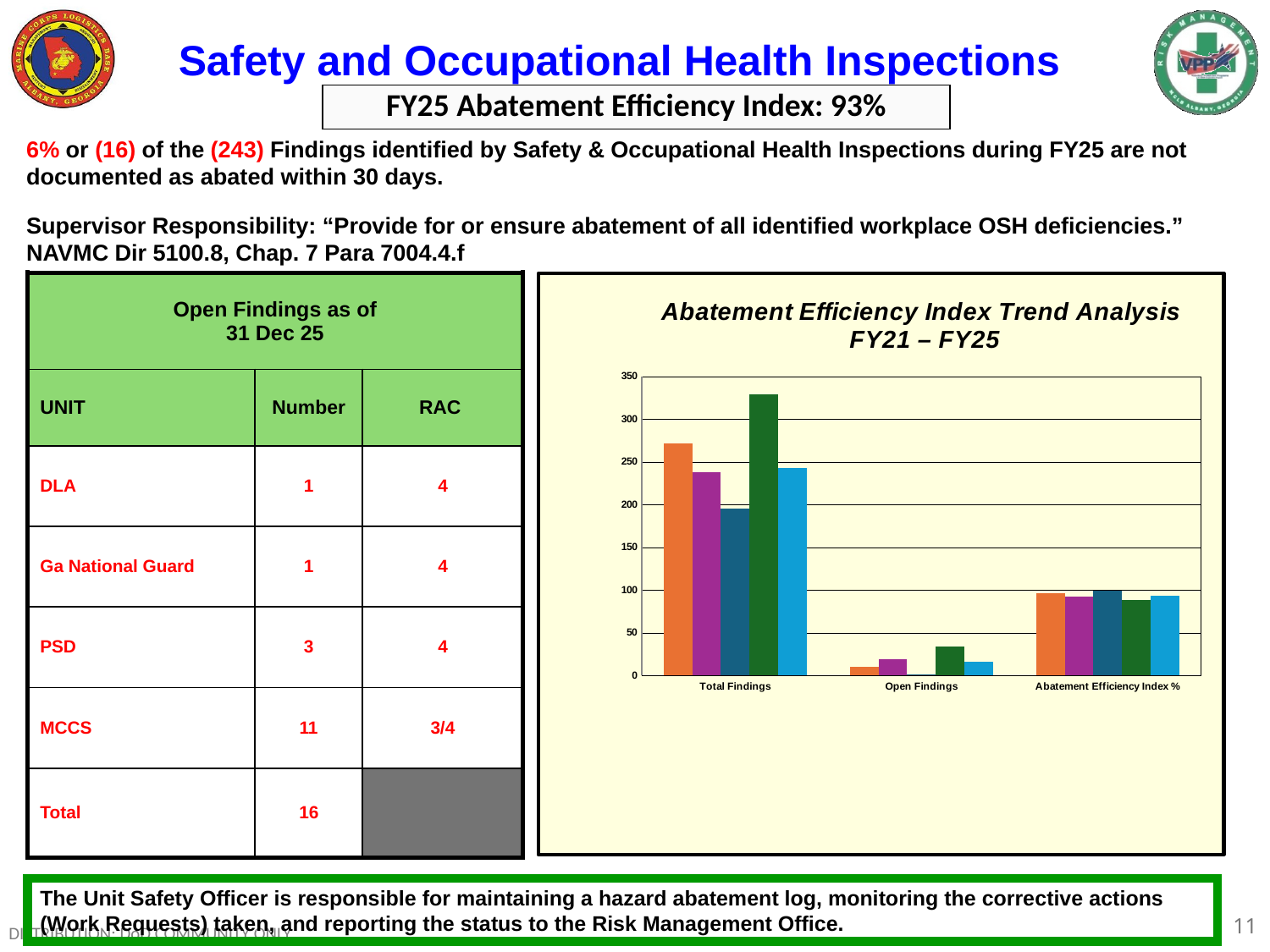
Which category on the Abatement Efficiency Index Trend Analysis chart contains the tallest bar? Total Findings On the Abatement Efficiency Index Trend Analysis chart, are all the bars in the Open Findings category greater or less than 50? less How many categories are shown on the x axis of the Abatement Efficiency Index Trend Analysis chart? 3 Which category on the Abatement Efficiency Index Trend Analysis chart has the lowest bars overall? Open Findings On the Abatement Efficiency Index Trend Analysis chart, which category has larger values: Total Findings or Open Findings? Total Findings On the Abatement Efficiency Index Trend Analysis chart, is the tallest bar in the Total Findings category greater or less than 300? greater How many bars are plotted in each category of the Abatement Efficiency Index Trend Analysis chart? 5 What fiscal year range is given in the title of the bar chart on the slide? FY21 – FY25 What kind of chart is shown under the title "Abatement Efficiency Index Trend Analysis FY21 – FY25"? Bar chart On the Abatement Efficiency Index Trend Analysis chart, are the bars in the Abatement Efficiency Index % category greater or less than 50? greater What is the highest value shown on the y axis of the Abatement Efficiency Index Trend Analysis chart? 350